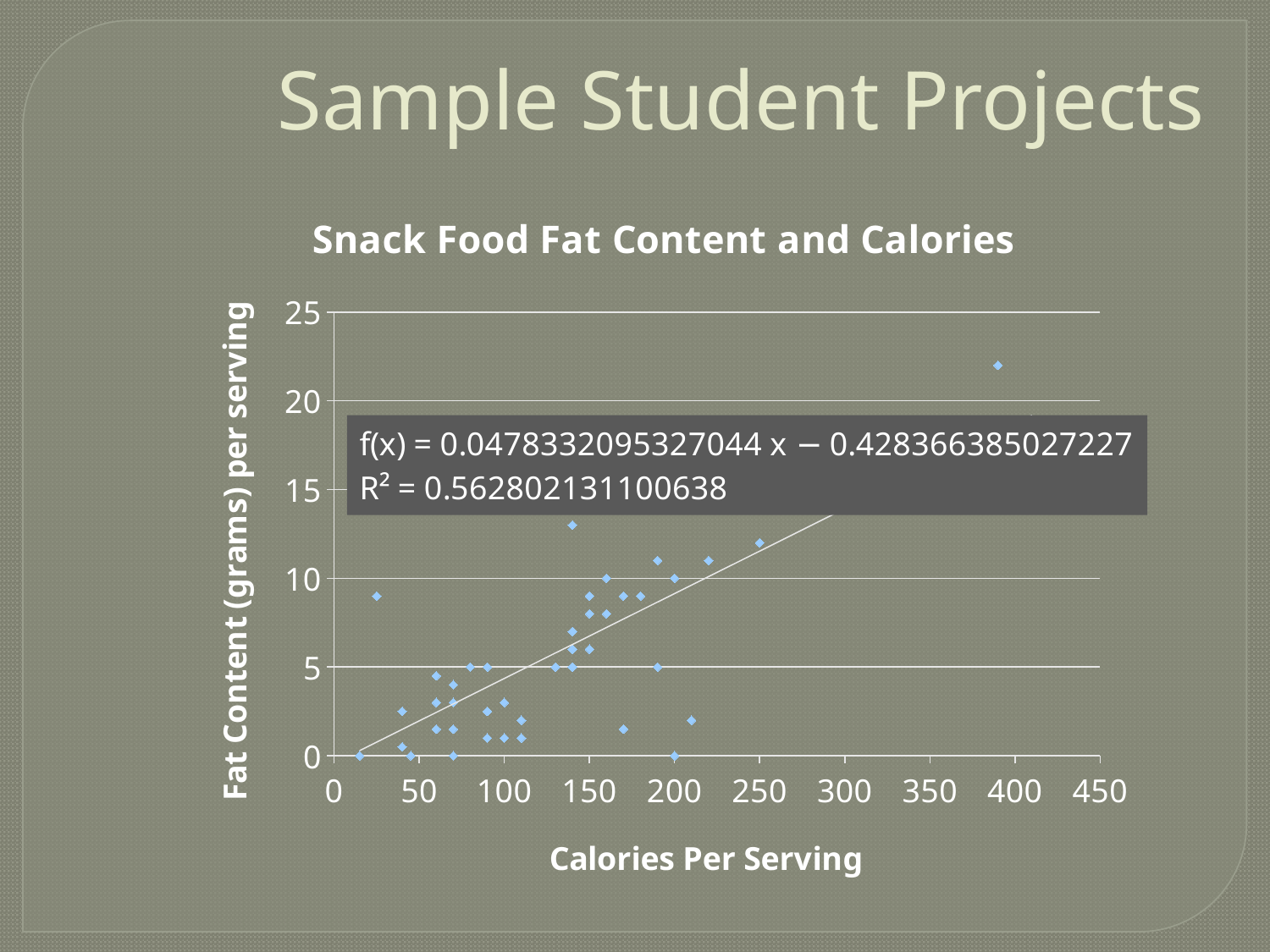
What R² value is printed on the chart? 0.562802131100638 What is the title of the chart? Snack Food Fat Content and Calories Which has the higher fat content: the point at about 390 calories or the point at about 250 calories? the point at about 390 calories What is the highest value shown on the x axis? 450 What kind of chart is shown on the slide? scatter chart What is the highest value shown on the y axis? 25 Is the calories-per-serving value of the point with the highest fat content greater or less than 350? greater Does fat content generally rise or fall as calories per serving increase? rise